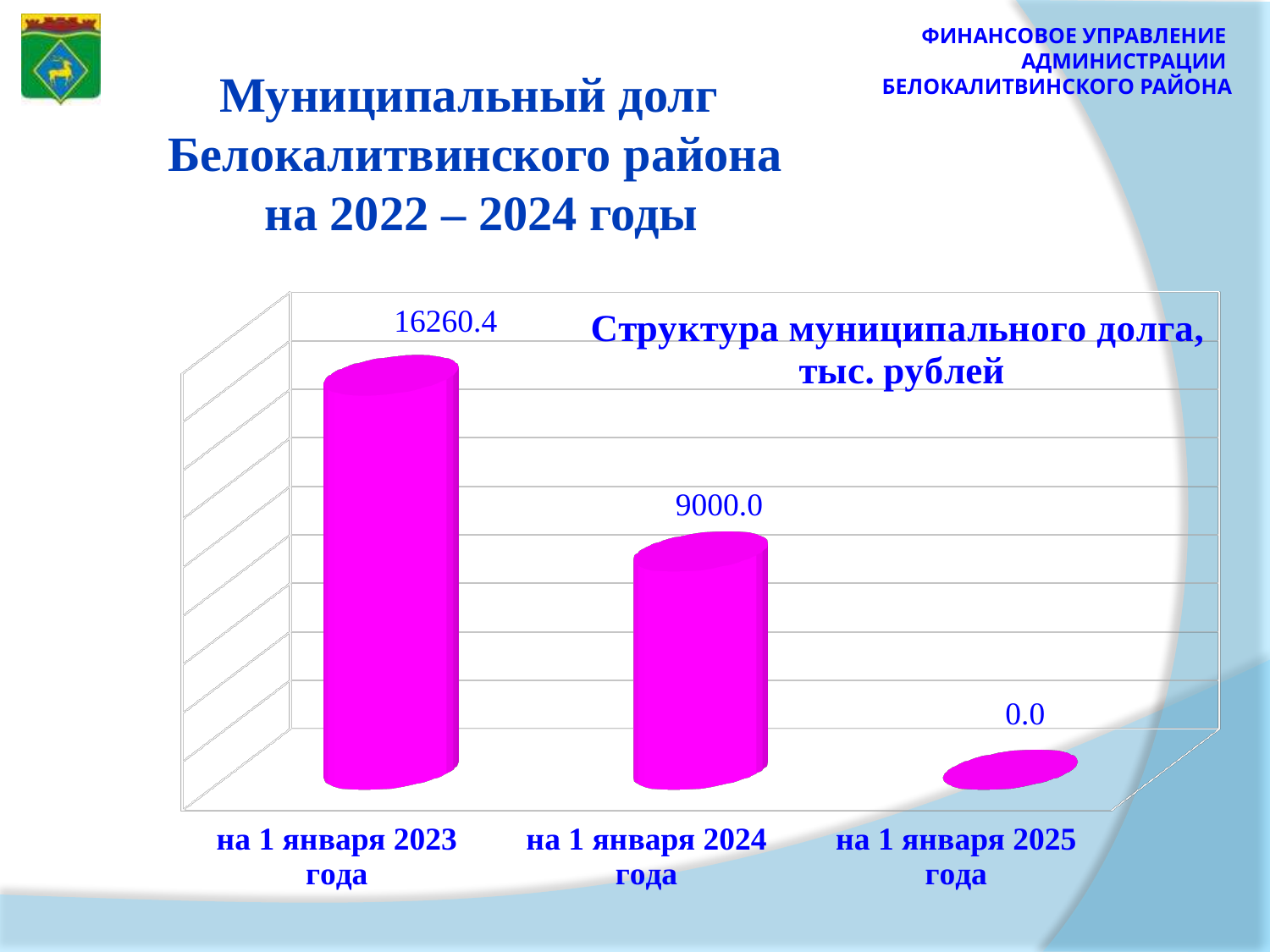
How many categories are shown on the chart? 3 Which category has the lowest value? на 1 января 2025 года What is the value for 'на 1 января 2025 года'? 0.0 What colour are the bars on the chart? magenta What is the title of the chart? Структура муниципального долга, тыс. рублей Which category has the highest value? на 1 января 2023 года What is the difference between the values for 'на 1 января 2023 года' and 'на 1 января 2024 года'? 7260.4 What is the value for 'на 1 января 2023 года'? 16260.4 Do the values rise or fall from left to right along the x axis? fall Which is larger: the value for 'на 1 января 2024 года' or 'на 1 января 2025 года'? на 1 января 2024 года What is the value for 'на 1 января 2024 года'? 9000.0 What kind of chart is shown on the slide? bar chart